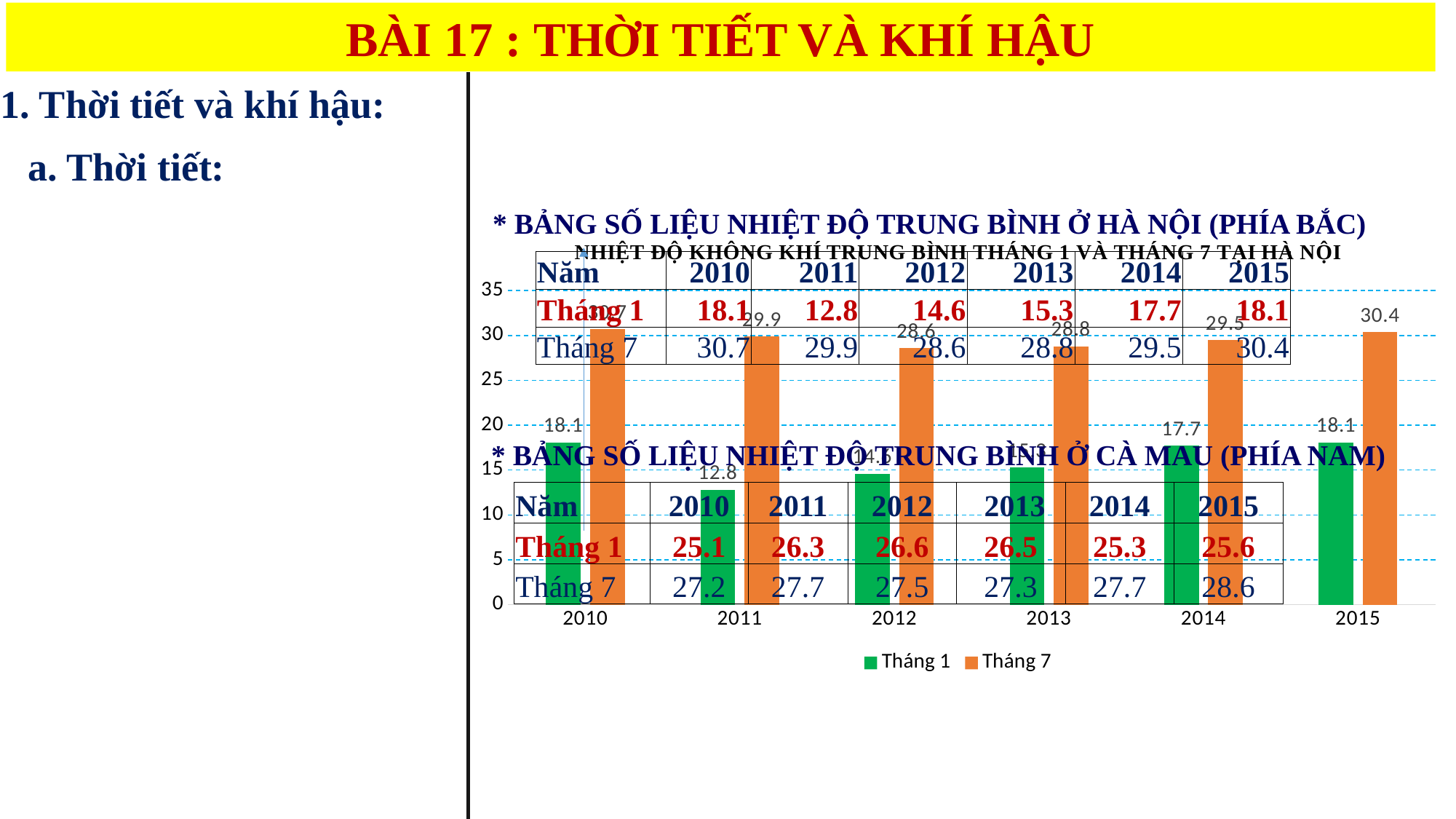
What is the Tháng 1 value for 2014 in the chart? 17.7 How many years are shown on the x axis of the chart? 6 Which colour represents the Tháng 7 series in the chart? orange What kind of chart is shown on the slide? bar chart Which year has the lowest Tháng 1 value in the chart? 2011 What is the difference between the Tháng 7 and Tháng 1 values for 2015? 12.3 Which year has the lowest Tháng 7 value in the chart? 2012 How many series does the chart legend list? 2 Is the Tháng 1 value for 2014 greater or less than 20? less What is the Tháng 7 value for 2015 in the chart? 30.4 What is the Tháng 1 value for 2011 in the chart? 12.8 What is the Tháng 7 value for 2011 in the chart? 29.9